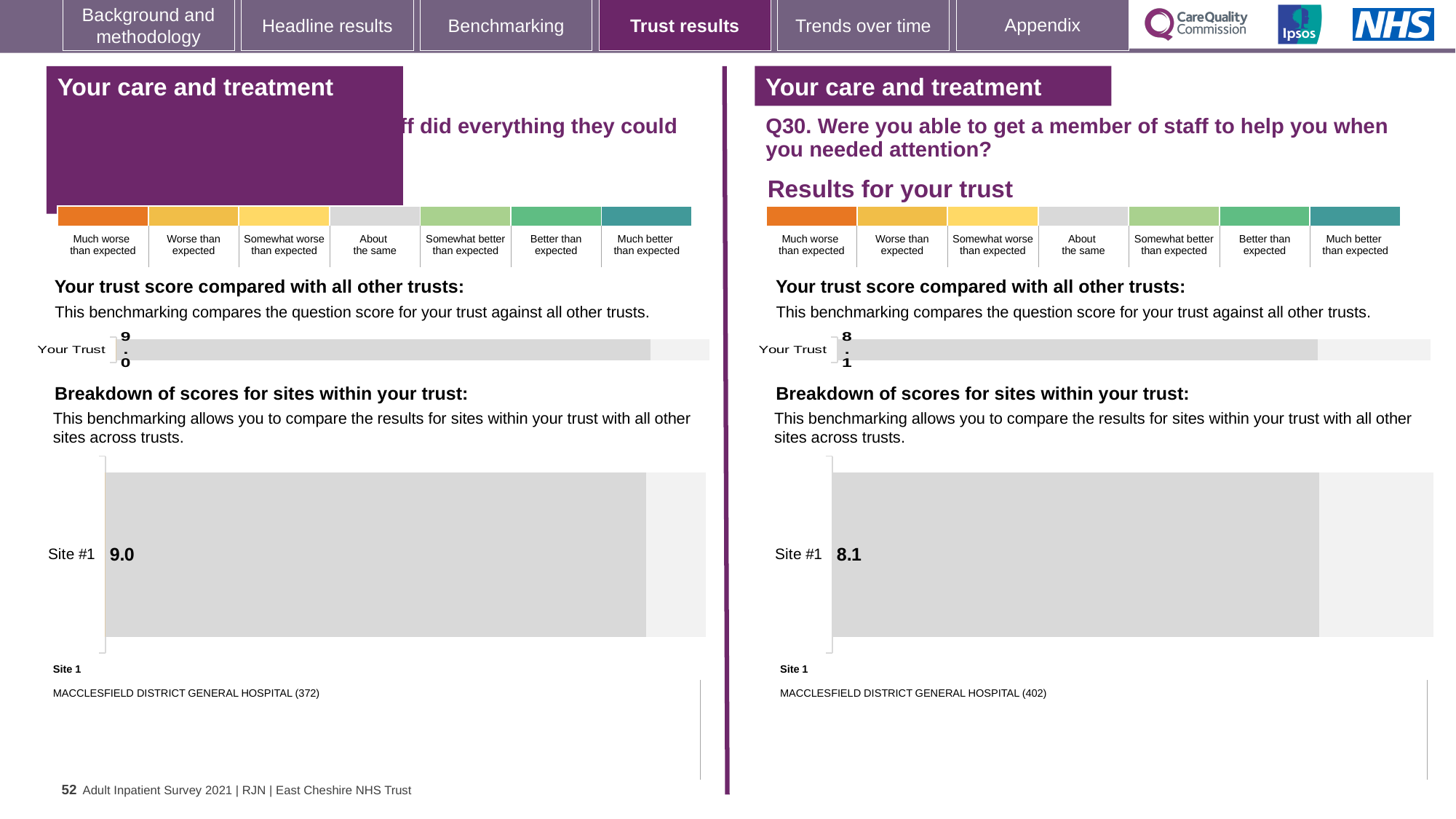
On the right half of the slide (Q30), which hospital is listed as Site 1? MACCLESFIELD DISTRICT GENERAL HOSPITAL (402) On the left half of the slide, what score is shown for Site #1 in the 'Breakdown of scores for sites within your trust' chart? 9.0 On the right half of the slide (Q30), what is the score shown for Your Trust in the 'Your trust score compared with all other trusts' chart? 8.1 Is the Your Trust score on the right half of the slide (Q30) greater or less than the Your Trust score on the left half? less On the right half of the slide (Q30), what score is shown for Site #1 in the 'Breakdown of scores for sites within your trust' chart? 8.1 What type of chart is used to show the Site #1 score on the right half of the slide (Q30)? Bar chart How many sites are plotted in the 'Breakdown of scores for sites within your trust' chart on the left half of the slide? 1 On the left half of the slide, which hospital is listed as Site 1? MACCLESFIELD DISTRICT GENERAL HOSPITAL (372) How many sites are plotted in the 'Breakdown of scores for sites within your trust' chart on the right half of the slide (Q30)? 1 On the left half of the slide, what is the score shown for Your Trust in the 'Your trust score compared with all other trusts' chart? 9.0 Which is larger: the Site #1 score on the left half of the slide or the Site #1 score on the right half (Q30)? Left half (9.0) What is the difference between the Your Trust score on the left half of the slide (9.0) and the Your Trust score on the right half (8.1)? 0.9